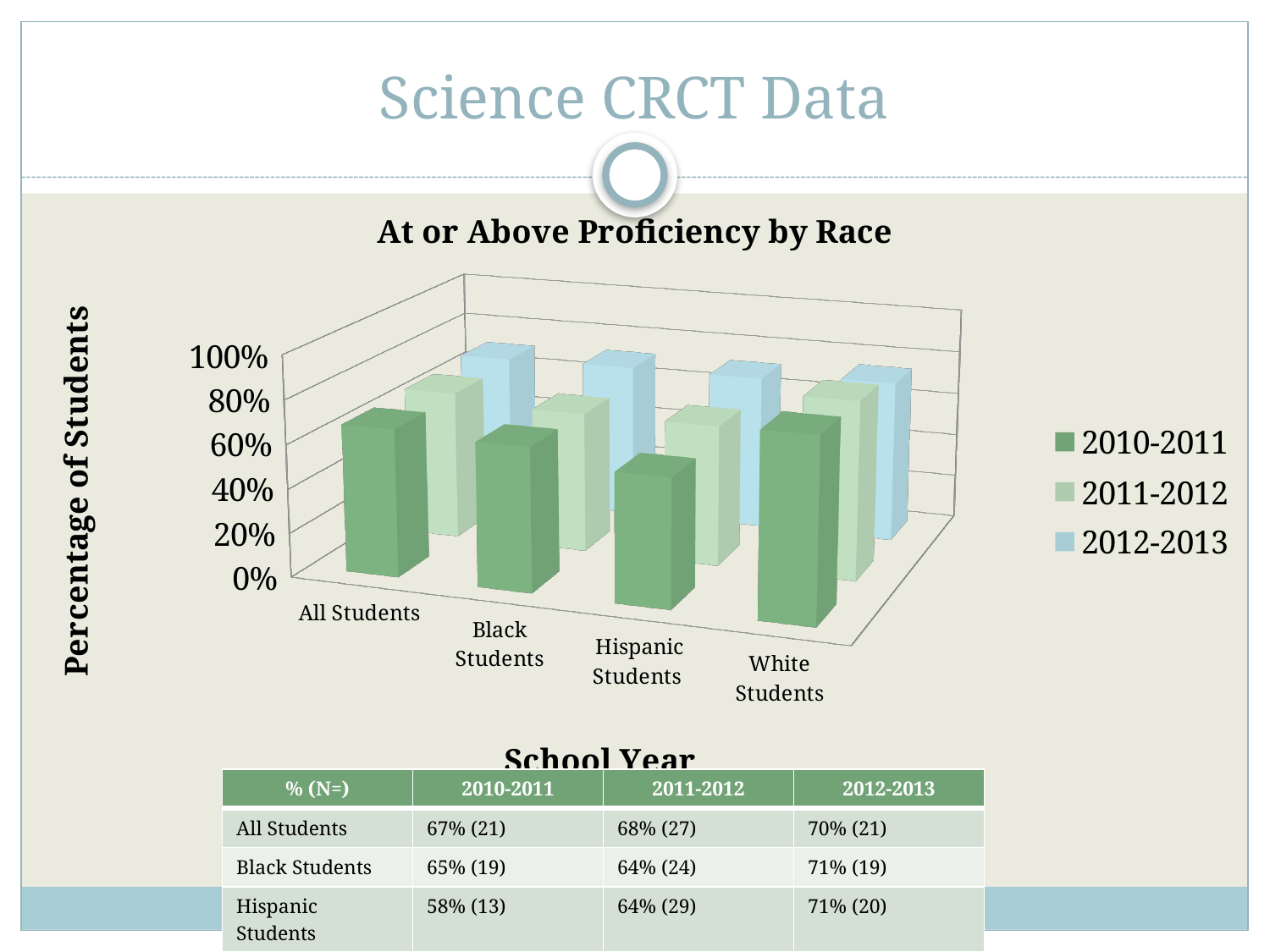
What percentage of Black Students were at or above proficiency in 2011-2012? 64% Which student group had the lowest value in 2010-2011? Hispanic Students What kind of chart is shown on the slide? bar chart By how many percentage points did the Hispanic Students value increase from 2010-2011 to 2012-2013? 13 What percentage of Hispanic Students were at or above proficiency in 2010-2011? 58% How many student groups are shown along the x axis of the chart? 4 Is the 2010-2011 value for White Students greater or less than 40%? greater How many series does the chart legend list? 3 What percentage of All Students were at or above proficiency in 2012-2013? 70% What is the title of the chart? At or Above Proficiency by Race In 2010-2011, which was larger: the value for Black Students or the value for Hispanic Students? Black Students What is the label on the vertical axis of the chart? Percentage of Students